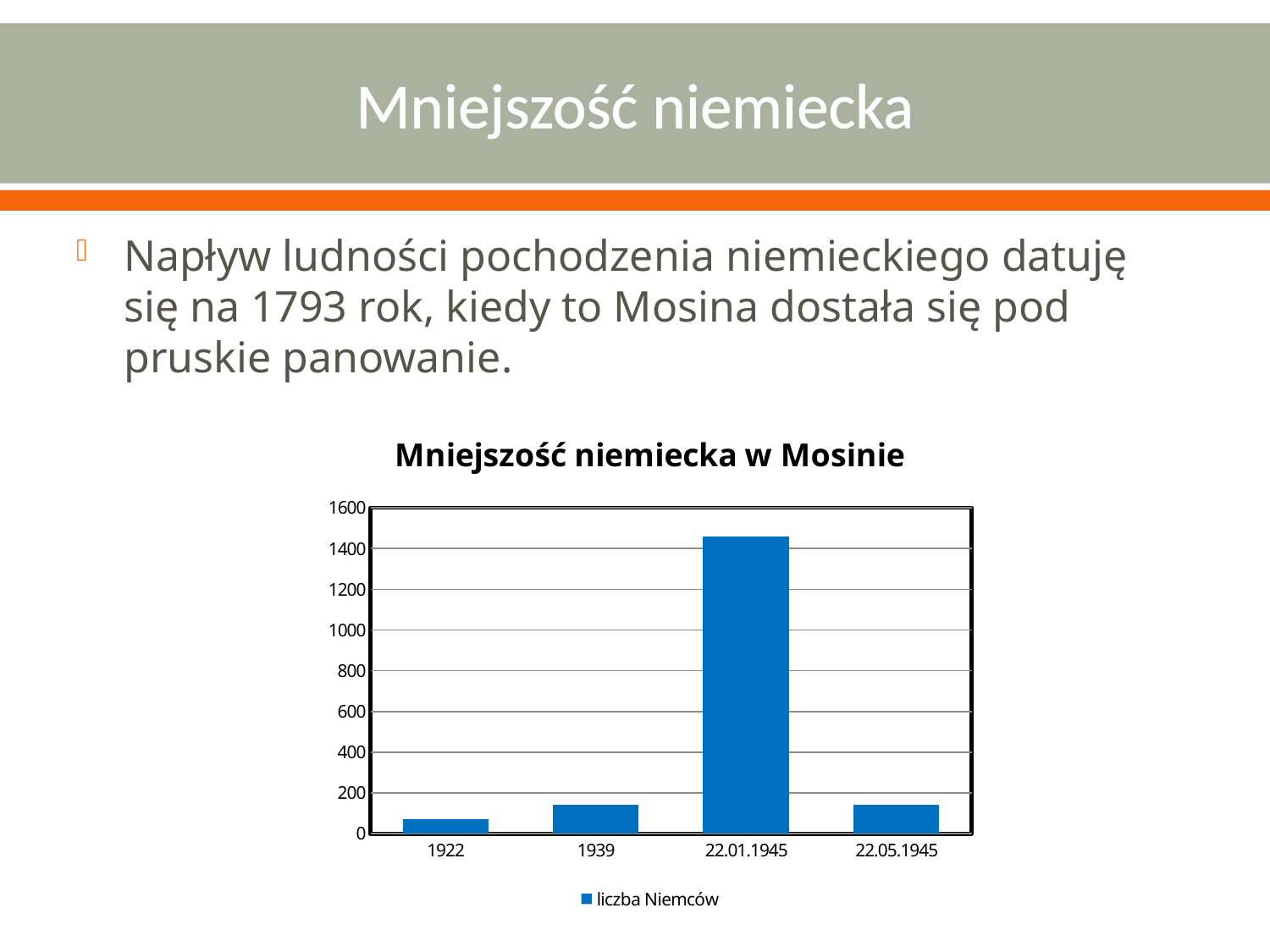
Which category has the lowest value in the chart? 1922 Which category has the highest value in the chart? 22.01.1945 What series name is shown in the chart legend? liczba Niemców Is the value for 1922 greater or less than 200? less Is the value for 1939 greater or less than 200? less Which is larger, the value for 22.01.1945 or the value for 22.05.1945? 22.01.1945 Which is larger, the value for 1922 or the value for 1939? 1939 How many series does the chart legend list? 1 How many categories are shown on the x axis of the chart? 4 Is the value for 22.01.1945 greater or less than 1400? greater What is the title of the chart? Mniejszość niemiecka w Mosinie What type of chart is shown on the slide? bar chart